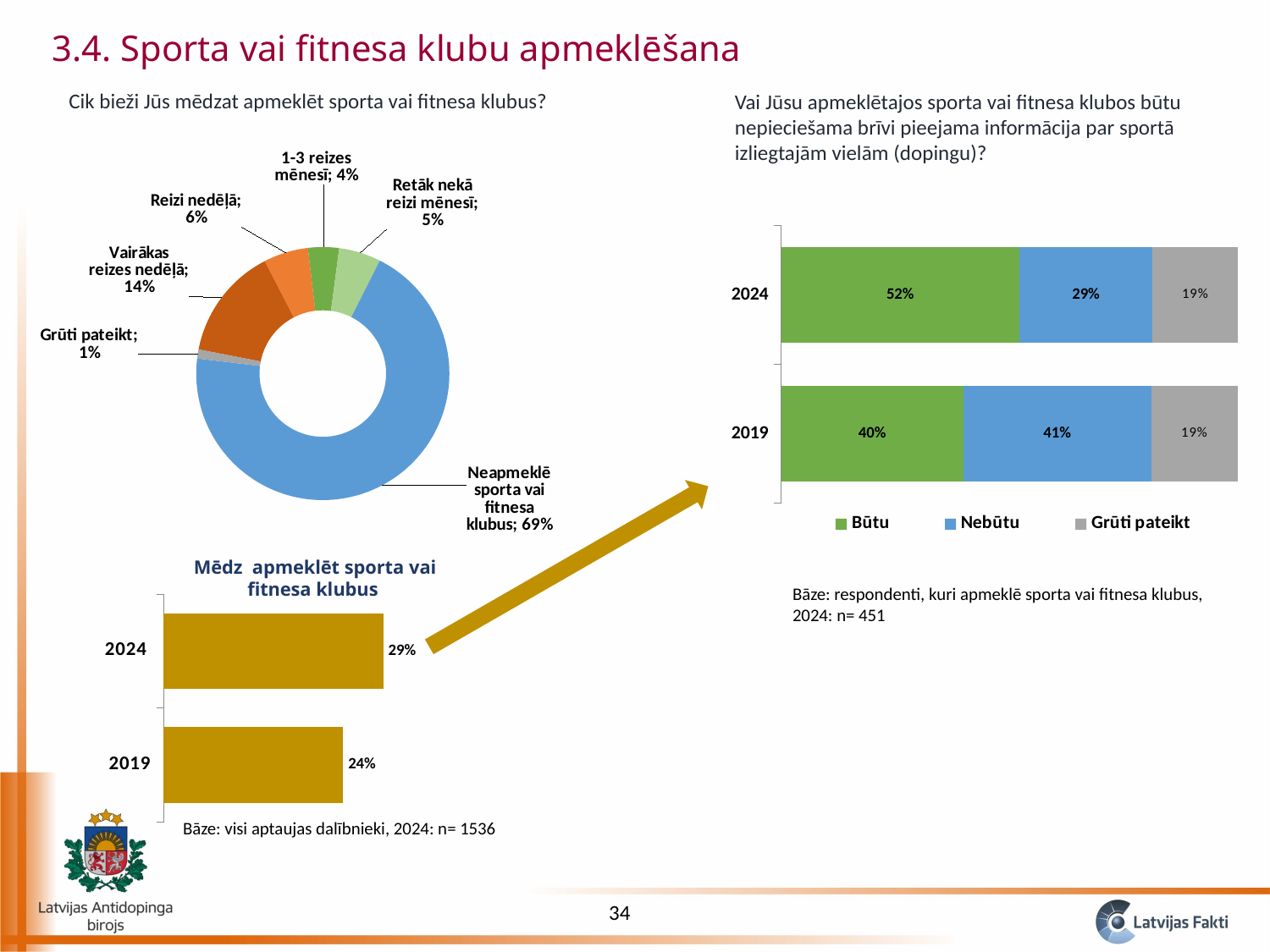
What kind of chart is the chart titled "Mēdz apmeklēt sporta vai fitnesa klubus"? bar chart In the stacked bar chart on the right, what is the difference between the "Būtu" values for 2024 and 2019? 12% In the donut chart on the left, how many categories are shown? 6 In the donut chart on the left, which category has the smallest share? Grūti pateikt In the donut chart on the left, what share of respondents answered "Neapmeklē sporta vai fitnesa klubus"? 69% In the chart titled "Mēdz apmeklēt sporta vai fitnesa klubus", what is the difference between the 2024 and 2019 values? 5% In the stacked bar chart on the right, how many series does the legend list? 3 In the chart titled "Mēdz apmeklēt sporta vai fitnesa klubus", what is the value for 2024? 29% In the donut chart on the left, which is larger: "Reizi nedēļā" or "1-3 reizes mēnesī"? Reizi nedēļā In the donut chart on the left, what share of respondents answered "Vairākas reizes nedēļā"? 14% In the stacked bar chart on the right, what is the "Nebūtu" value for 2019? 41% In the stacked bar chart on the right, what is the "Būtu" value for 2024? 52%